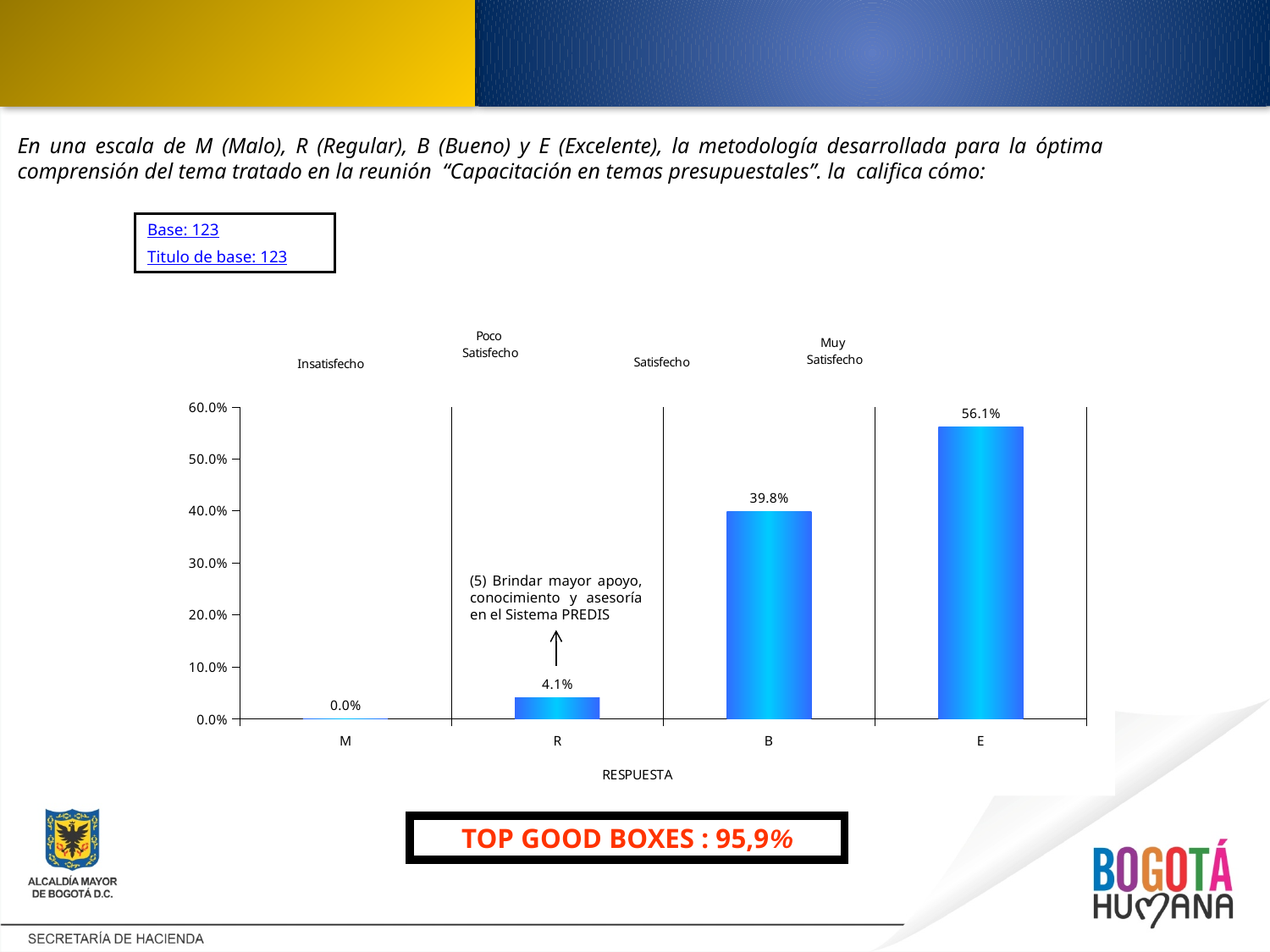
What is the difference between the values for E and B? 16.3% What is the value for category E? 56.1% What kind of chart is shown? bar chart What is the value for category M? 0.0% Which is larger, the value for B or the value for R? B Which category has the lowest value? M Which category has the highest value? E What is the value for category B? 39.8% What is the label of the x axis? RESPUESTA What is the value for category R? 4.1% How many categories are shown on the x axis? 4 Is the value for E greater or less than 50.0%? greater